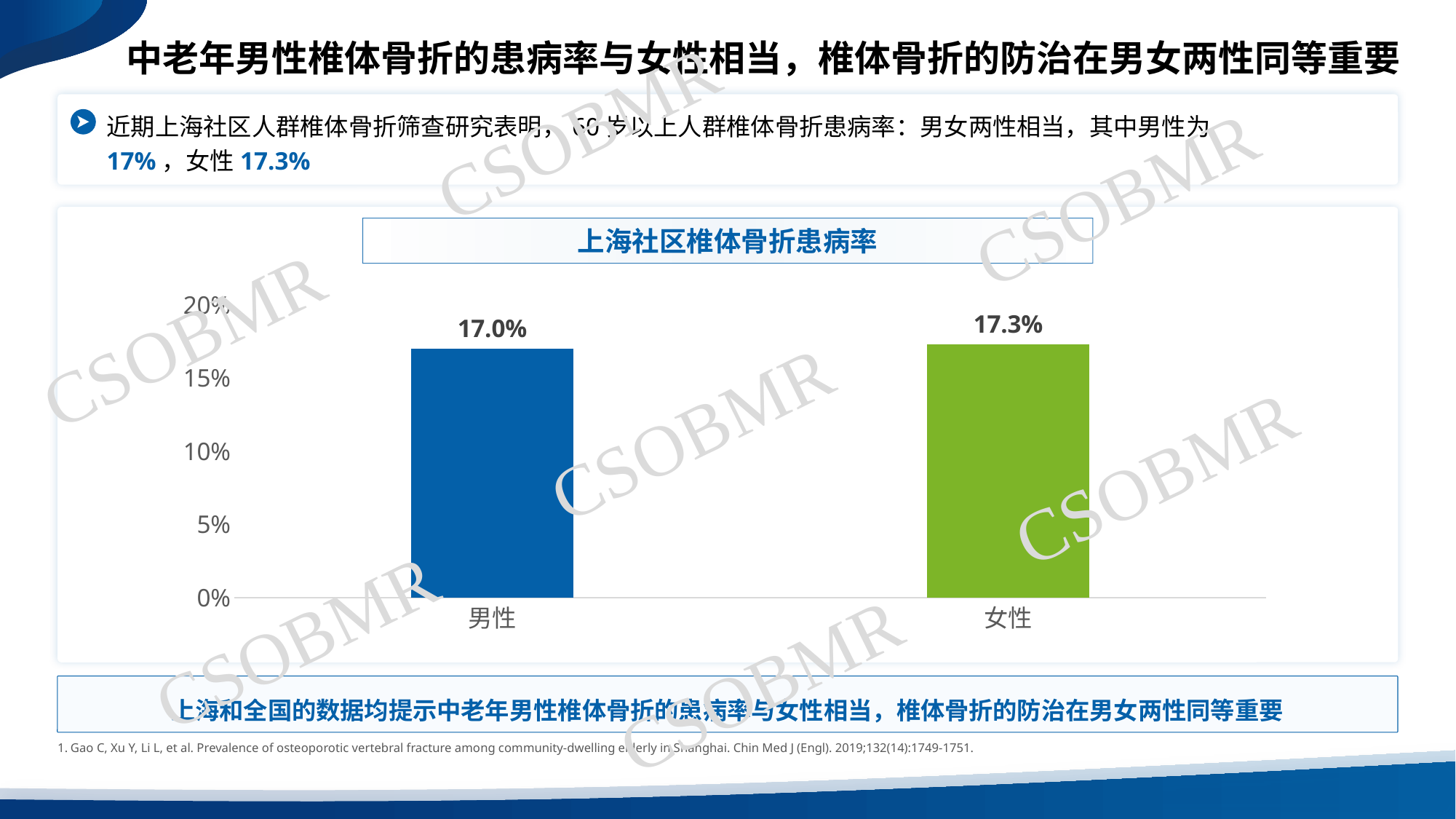
What is the highest tick value shown on the y axis of the chart? 20% Is the value for 男性 greater or less than 15%? greater Is the value for 女性 greater or less than 20%? less How many categories are shown on the x axis of the chart? 2 What is the vertebral fracture prevalence for 女性 (females) in the chart? 17.3% What colour is the bar for 女性? Green What is the vertebral fracture prevalence for 男性 (males) in the chart? 17.0% Which category has the lower prevalence according to the data labels? 男性 What is the difference between the prevalence for 女性 and 男性? 0.3% What is the title of the chart? 上海社区椎体骨折患病率 Which category has the higher prevalence according to the data labels, 男性 or 女性? 女性 What kind of chart is shown on the slide? Bar chart